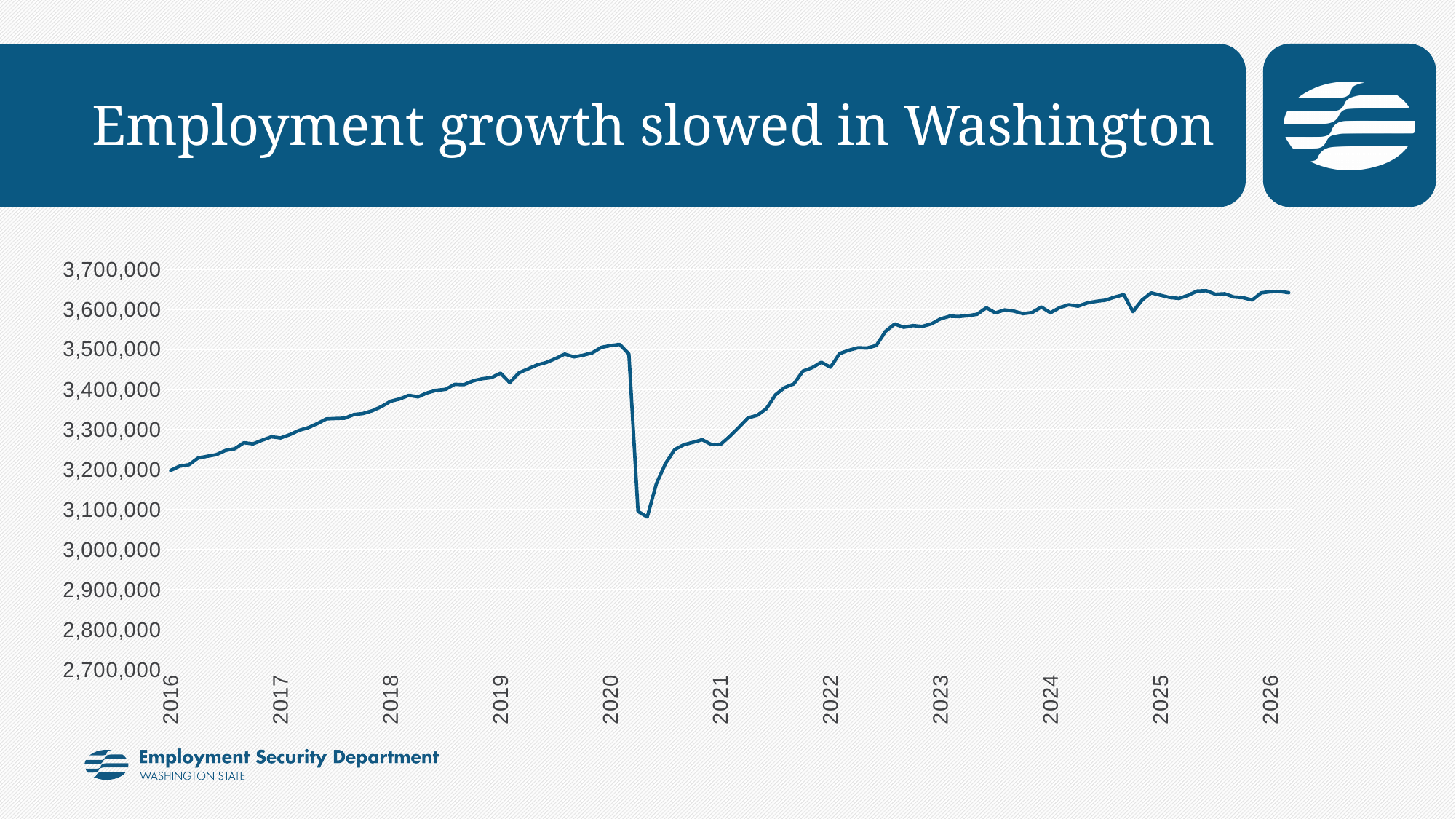
Is the value at the 2022 tick greater or less than 3,400,000? greater Does the line generally rise or fall between 2016 and the start of 2020? rise What kind of chart is shown on the slide? line chart Does the line generally rise or fall between 2021 and 2024? rise How many years are labeled on the x axis? 11 In which year does the line reach its lowest point? 2020 What is the highest value shown on the y axis? 3,700,000 Is the value at the 2018 tick greater or less than 3,300,000? greater What is the title of the slide? Employment growth slowed in Washington Is the value at the 2026 tick greater or less than 3,600,000? greater Which is larger, the value at the 2016 tick or the value at the 2019 tick? 2019